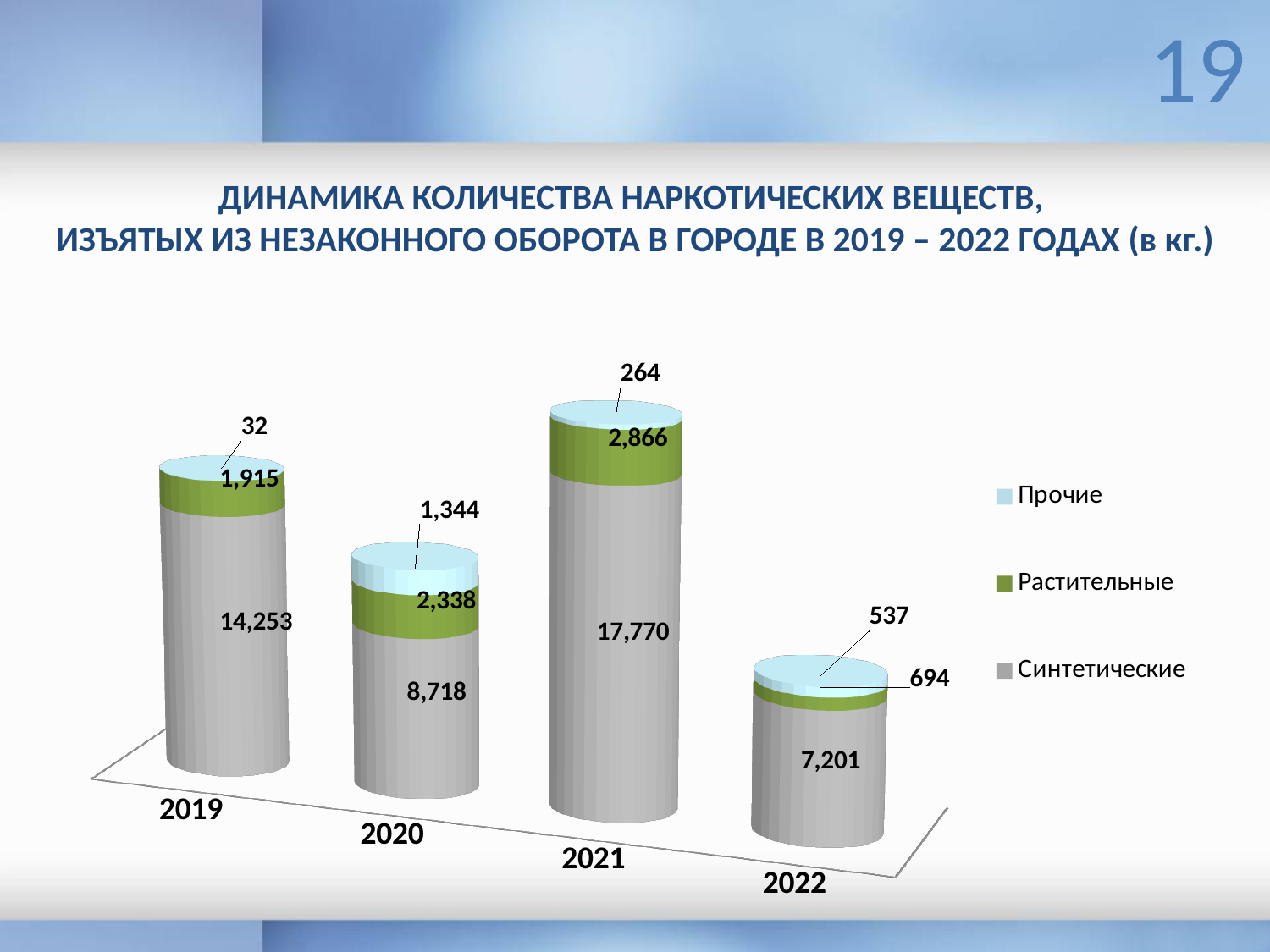
What is the difference between the Синтетические values for 2019 and 2020? 5,535 What kind of chart is shown on the slide? Stacked bar chart How many series does the legend list? 3 What is the value for Растительные in 2020? 2,338 What is the value for Синтетические in 2021? 17,770 How many years are shown on the x axis? 4 What is the total of the stacked bar for 2022? 8,432 In which year is the Синтетические value the highest? 2021 In which year is the Синтетические value the lowest? 2022 Which is larger: the Прочие value for 2020 or for 2021? 2020 What is the value for Прочие in 2022? 537 What is the value for Прочие in 2019? 32